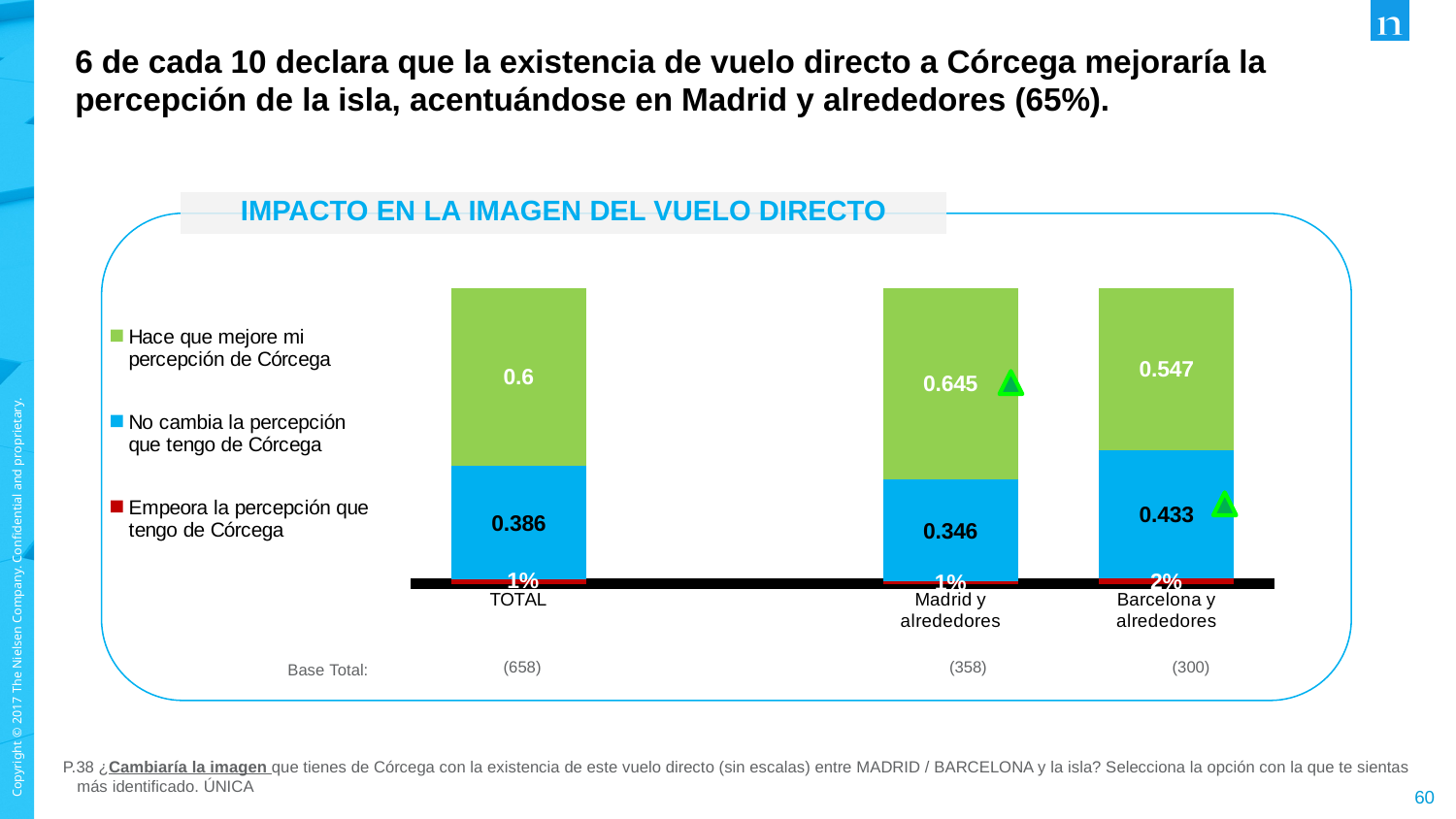
Which category has the lowest value for 'No cambia la percepción que tengo de Córcega'? Madrid y alrededores How many series does the legend list? 3 What is the title of the chart? IMPACTO EN LA IMAGEN DEL VUELO DIRECTO What is the value of 'No cambia la percepción que tengo de Córcega' for Madrid y alrededores? 0.346 Which is larger: the 'No cambia la percepción que tengo de Córcega' value for TOTAL or for Barcelona y alrededores? Barcelona y alrededores What is the value of 'Hace que mejore mi percepción de Córcega' for TOTAL? 0.6 Which category has the highest value for 'Hace que mejore mi percepción de Córcega'? Madrid y alrededores What is the value of 'Empeora la percepción que tengo de Córcega' for Barcelona y alrededores? 2% What is the value of 'Hace que mejore mi percepción de Córcega' for Barcelona y alrededores? 0.547 How many categories are shown on the x axis? 3 What is the difference between the 'Hace que mejore mi percepción de Córcega' values for Madrid y alrededores and Barcelona y alrededores? 0.098 What kind of chart is shown on the slide? Stacked bar chart